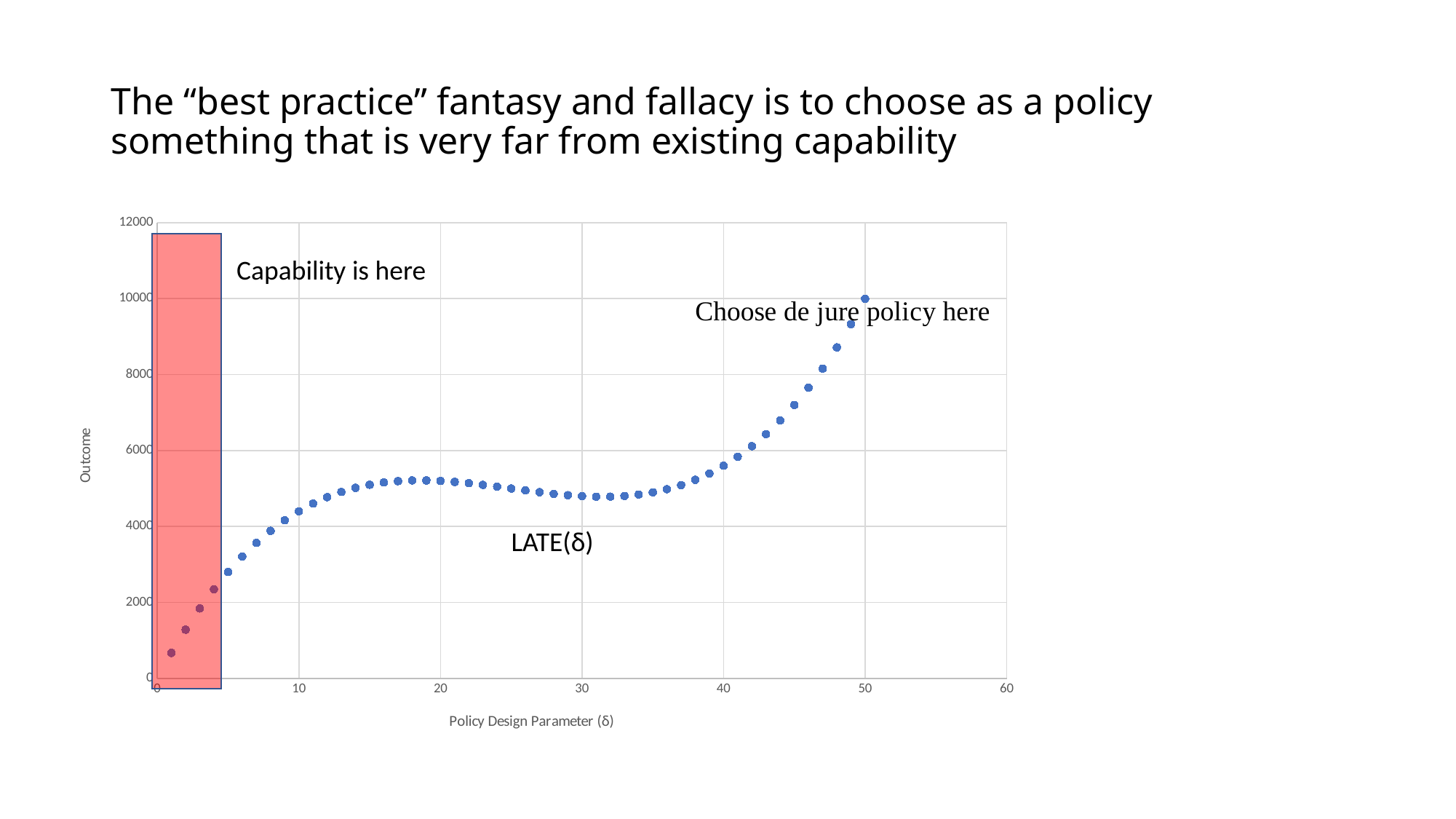
At which Policy Design Parameter value is the Outcome highest? 50 What is the label of the x axis of the chart? Policy Design Parameter (δ) Is the Outcome value at a Policy Design Parameter of 10 greater or less than 6000? less Is the Outcome value at a Policy Design Parameter of 30 greater or less than 6000? less Do the Outcome values rise or fall as the Policy Design Parameter increases from 40 to 50? Rise Is the Outcome value at a Policy Design Parameter of 50 greater or less than 8000? greater What kind of chart is shown on the slide? Scatter plot Do the Outcome values rise or fall as the Policy Design Parameter increases from 0 to 10? Rise Which has the larger Outcome: the point at Policy Design Parameter 50 or the point at Policy Design Parameter 30? Policy Design Parameter 50 What is the label of the y axis of the chart? Outcome